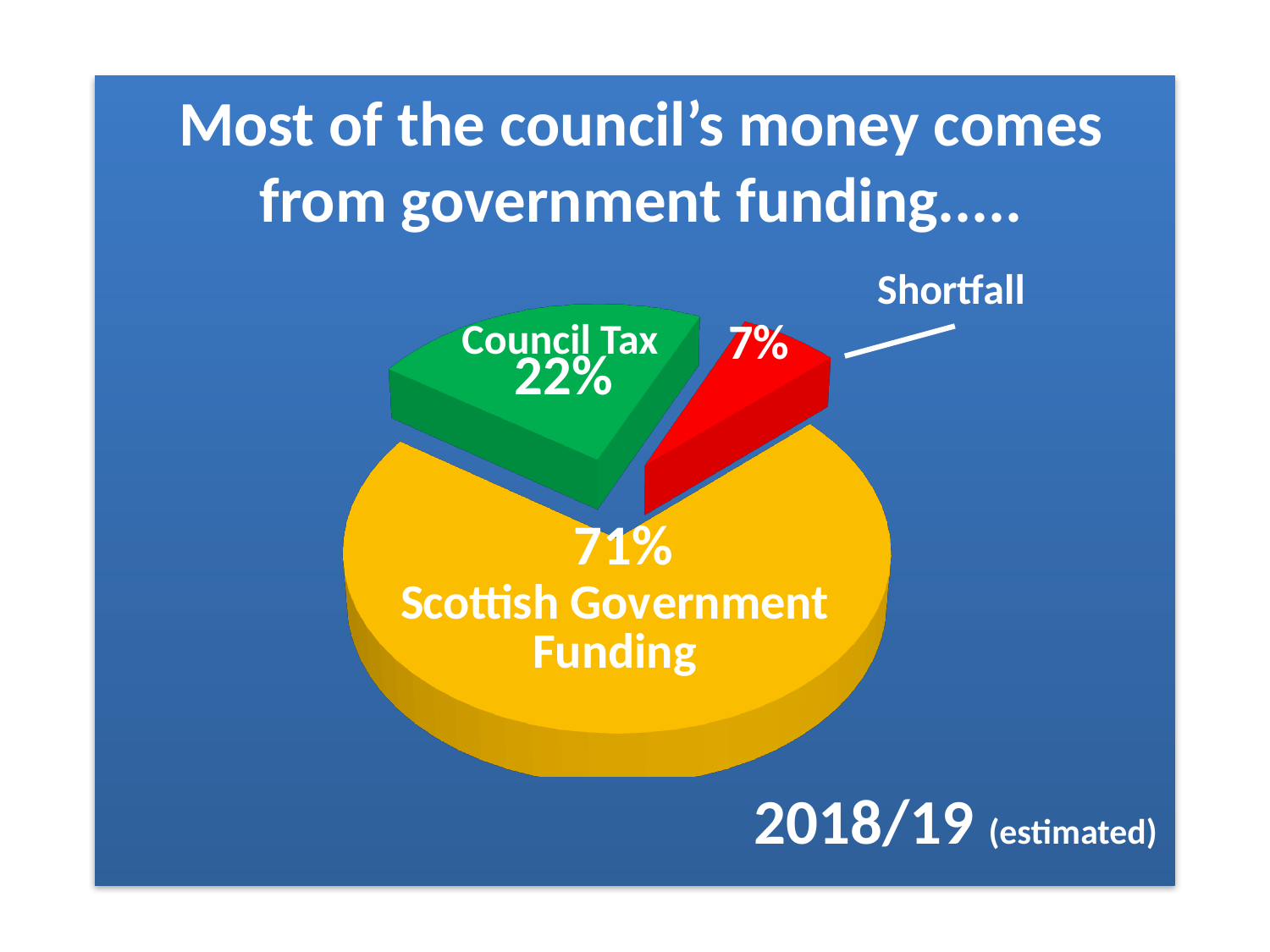
What share of the pie is the Shortfall? 7% Which slice of the pie is the smallest? Shortfall Which year does the pie chart refer to? 2018/19 (estimated) What share of the pie is Scottish Government Funding? 71% What kind of chart is shown on the slide? Pie chart What is the difference in percentage points between Council Tax and the Shortfall? 15 What share of the pie is Council Tax? 22% Which slice of the pie is the largest? Scottish Government Funding What colour is the Shortfall slice? Red How many slices does the pie chart have? 3 Which is larger, the Council Tax slice or the Shortfall slice? Council Tax What is the difference in percentage points between Scottish Government Funding and Council Tax? 49